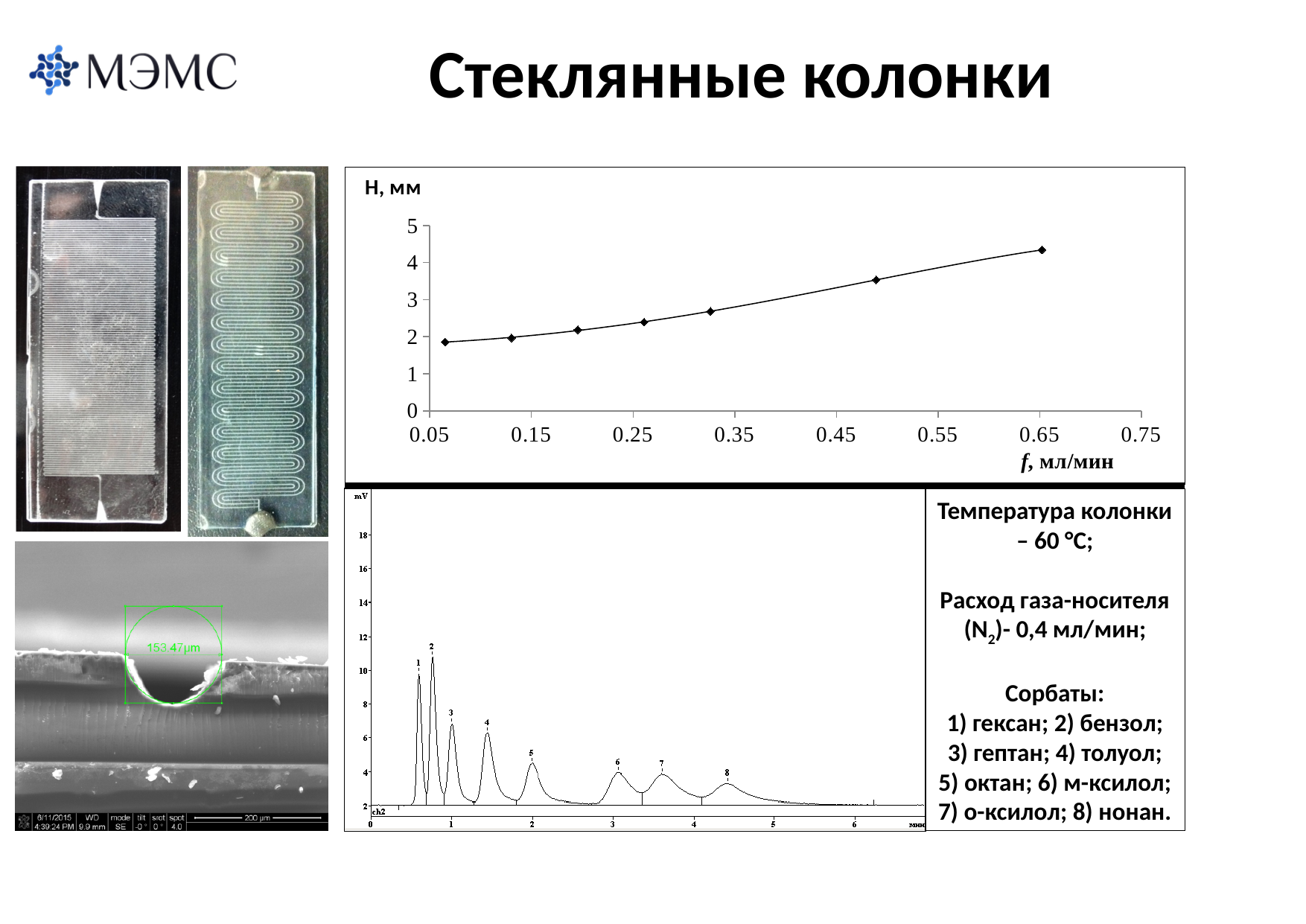
In the upper chart (H, мм vs f, мл/мин), is the H value of the rightmost point greater or less than 4? greater In the lower chromatogram, which is higher, peak 2 or peak 8? peak 2 In the upper chart (H, мм vs f, мл/мин), does H rise or fall as f increases? rise In the upper chart (H, мм vs f, мл/мин), how many data points are plotted? 7 In the lower chromatogram, is the height of peak 8 greater or less than 4 mV? less In the upper chart (H, мм vs f, мл/мин), is the H value of the leftmost point greater or less than 2? less In the upper chart, what is the label of the vertical axis? H, мм In the lower chromatogram, how many numbered peaks are shown? 8 In the lower chromatogram, which numbered peak is the lowest? 8 In the upper chart, what is the label of the horizontal axis? f, мл/мин What kind of chart is the upper chart with the H, мм axis? line chart In the lower chromatogram, which numbered peak is the highest? 2